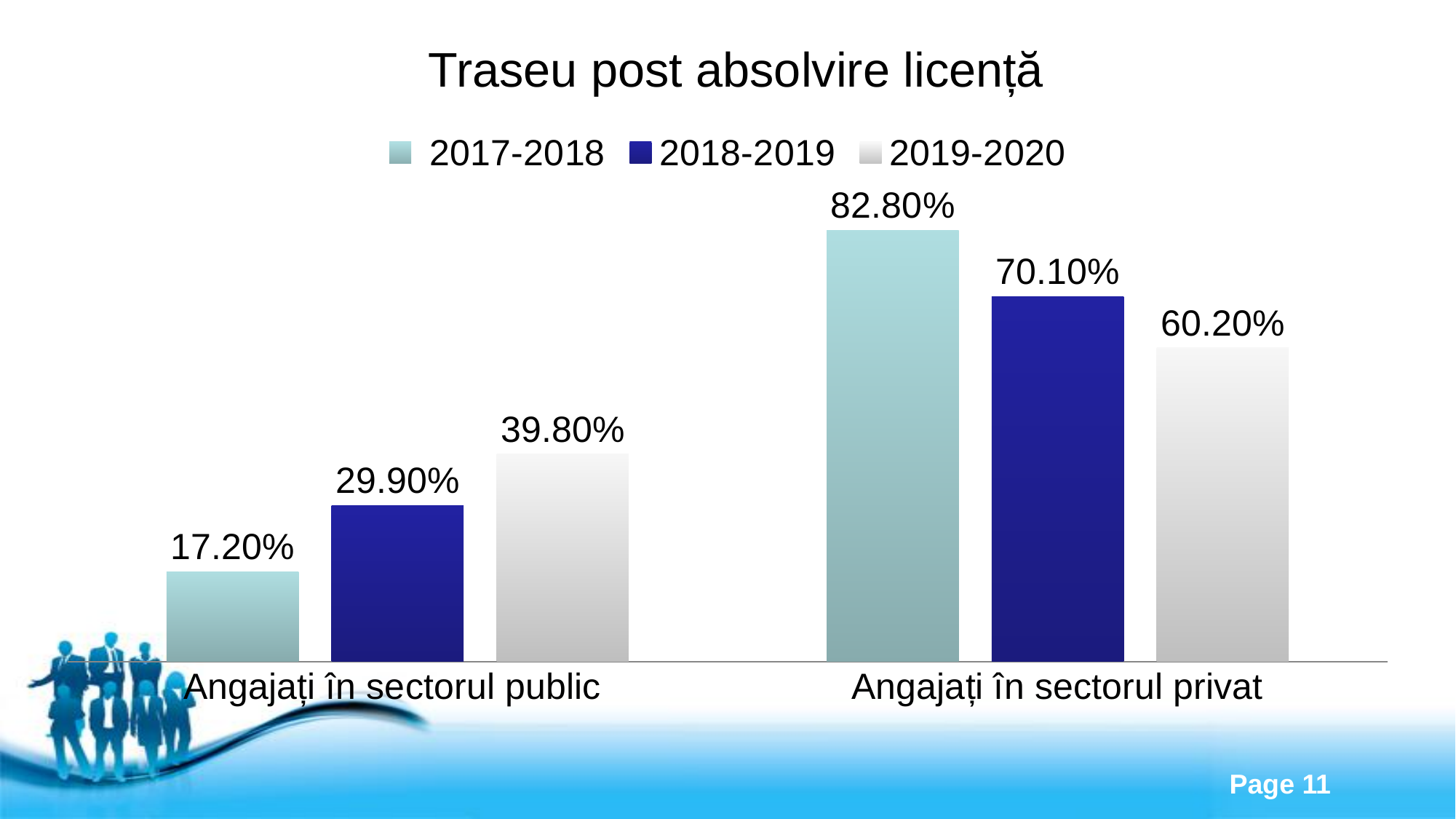
What is the value for 2018-2019 in the 'Angajați în sectorul public' category? 29.90% What is the value for 2017-2018 in the 'Angajați în sectorul public' category? 17.20% Which is larger: the 2019-2020 value for 'Angajați în sectorul public' or the 2019-2020 value for 'Angajați în sectorul privat'? Angajați în sectorul privat Which series has the lowest value in the 'Angajați în sectorul public' category? 2017-2018 Which series has the highest value in the 'Angajați în sectorul privat' category? 2017-2018 What is the difference between the 2017-2018 and 2018-2019 values in the 'Angajați în sectorul privat' category? 12.70% What is the value for 2019-2020 in the 'Angajați în sectorul privat' category? 60.20% How many categories are shown on the x axis? 2 How many series does the legend list? 3 What kind of chart is shown on the slide? Bar chart What is the difference between the 2019-2020 and 2017-2018 values in the 'Angajați în sectorul public' category? 22.60% What is the title of the chart? Traseu post absolvire licență